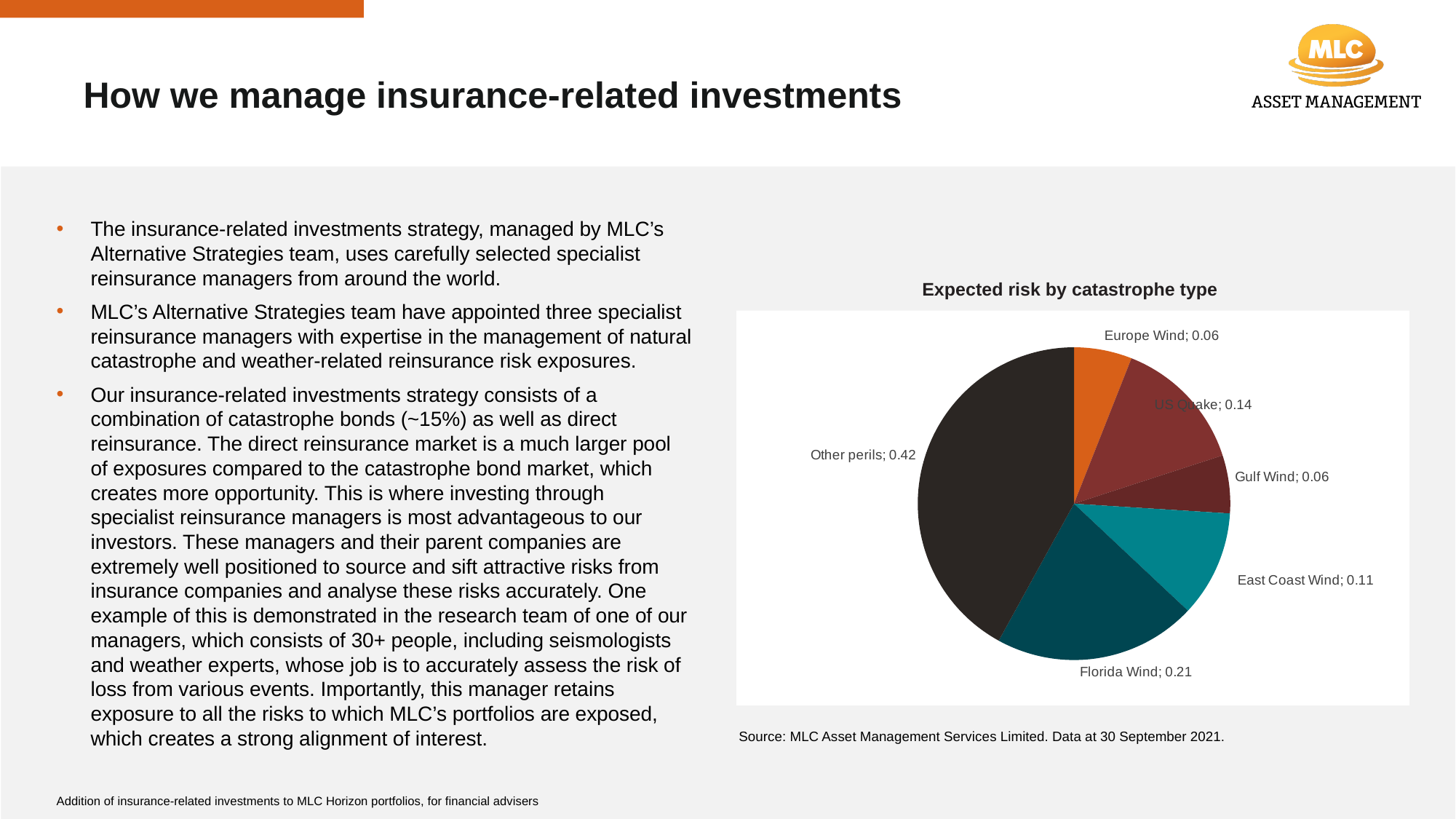
What is the value for US Quake in the pie chart? 0.14 What type of chart is shown on the slide? Pie chart Which catastrophe type has the largest slice of the pie chart? Other perils How many catastrophe types (slices) are shown in the pie chart? 6 What is the value for Other perils in the pie chart? 0.42 What share of the pie does Gulf Wind represent? 0.06 What is the value for Florida Wind in the pie chart? 0.21 What is the title of the chart? Expected risk by catastrophe type What is the value for East Coast Wind in the pie chart? 0.11 Which is larger, the value for US Quake or the value for East Coast Wind? US Quake What is the value for Europe Wind in the pie chart? 0.06 What is the difference between the values for Florida Wind and East Coast Wind? 0.10